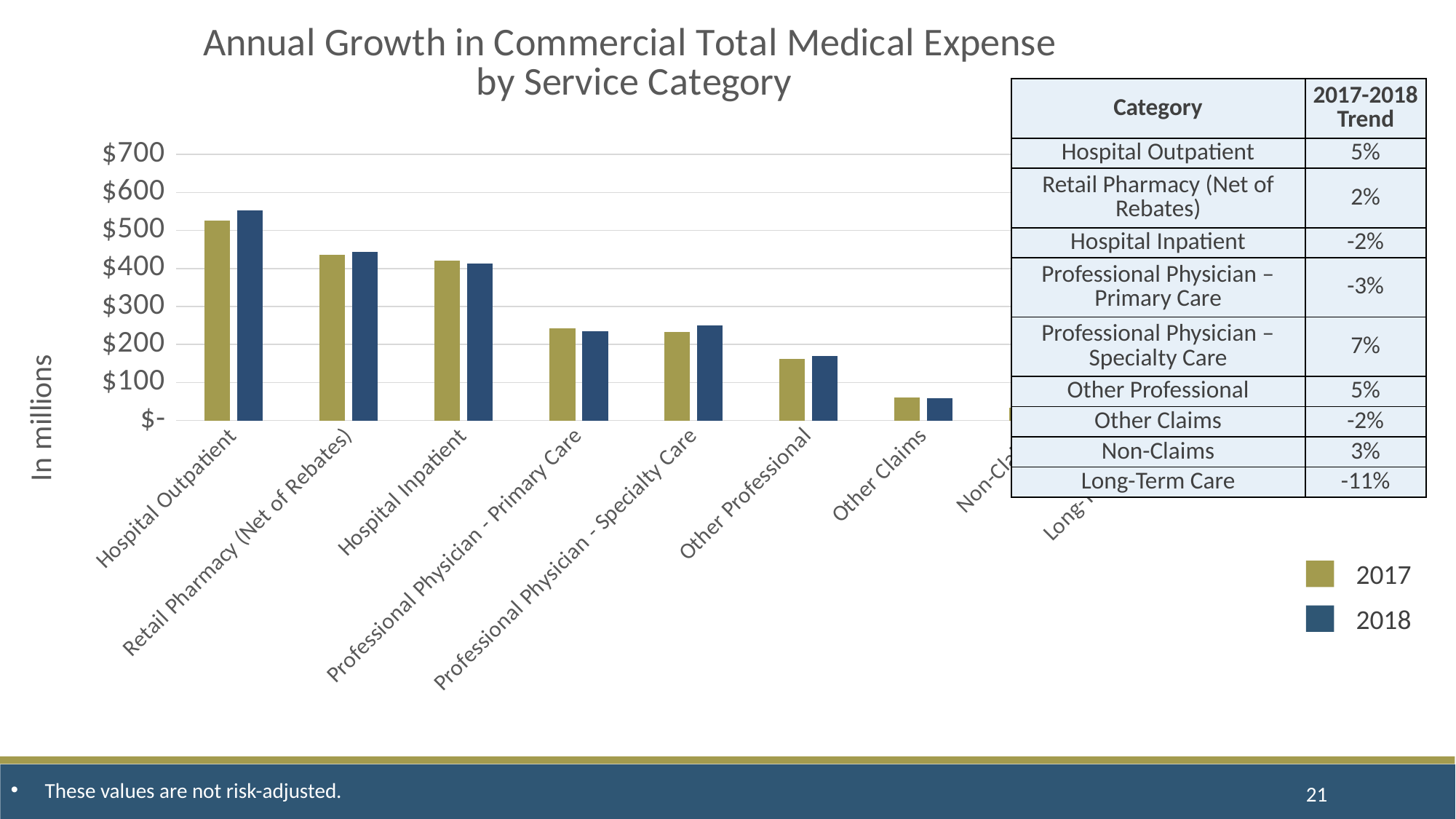
For Professional Physician - Specialty Care, which is larger: the 2017 value or the 2018 value? 2018 Is the 2017 value for Other Claims greater or less than $100? less Is the 2017 value for Professional Physician - Primary Care greater or less than $200? greater What is the label on the chart's vertical axis? In millions How many series does the chart legend list? 2 Do the bar values generally rise or fall moving from left to right along the x axis? fall Is the 2018 value for Hospital Outpatient greater or less than $500? greater Which service category has the highest 2017 value in the chart? Hospital Outpatient What kind of chart is shown on the slide? bar chart For Hospital Outpatient, which is larger: the 2017 value or the 2018 value? 2018 Which service category has the highest 2018 value in the chart? Hospital Outpatient